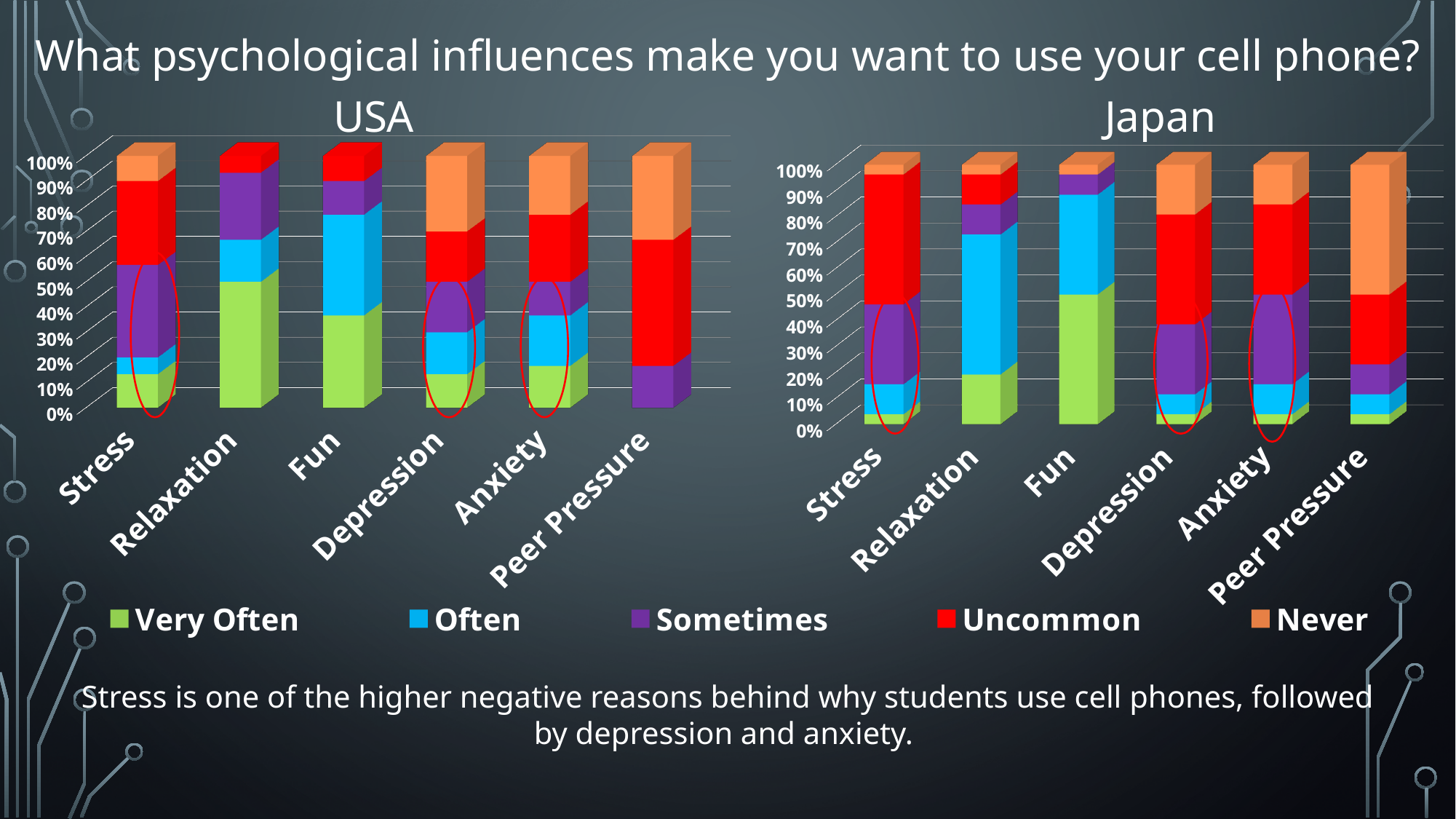
How many categories are shown on the x axis of the Japan chart? 6 In the Japan chart, is the Often share for Relaxation greater or less than 40%? greater In the USA chart, is the Very Often share for Relaxation greater or less than 40%? greater How many series does the legend list? 5 What kind of chart is the USA chart? Stacked bar chart In the USA chart, which is larger: the Very Often share for Relaxation or for Stress? Relaxation What are the titles of the two charts on the slide? USA and Japan In the Japan chart, which is larger: the Very Often share for Fun or for Depression? Fun In the USA chart, which category has the smallest Very Often share? Peer Pressure In the Japan chart, which category has the largest Very Often share? Fun In the USA chart, which category has the largest Very Often share? Relaxation Which series is shown in red in the legend? Uncommon